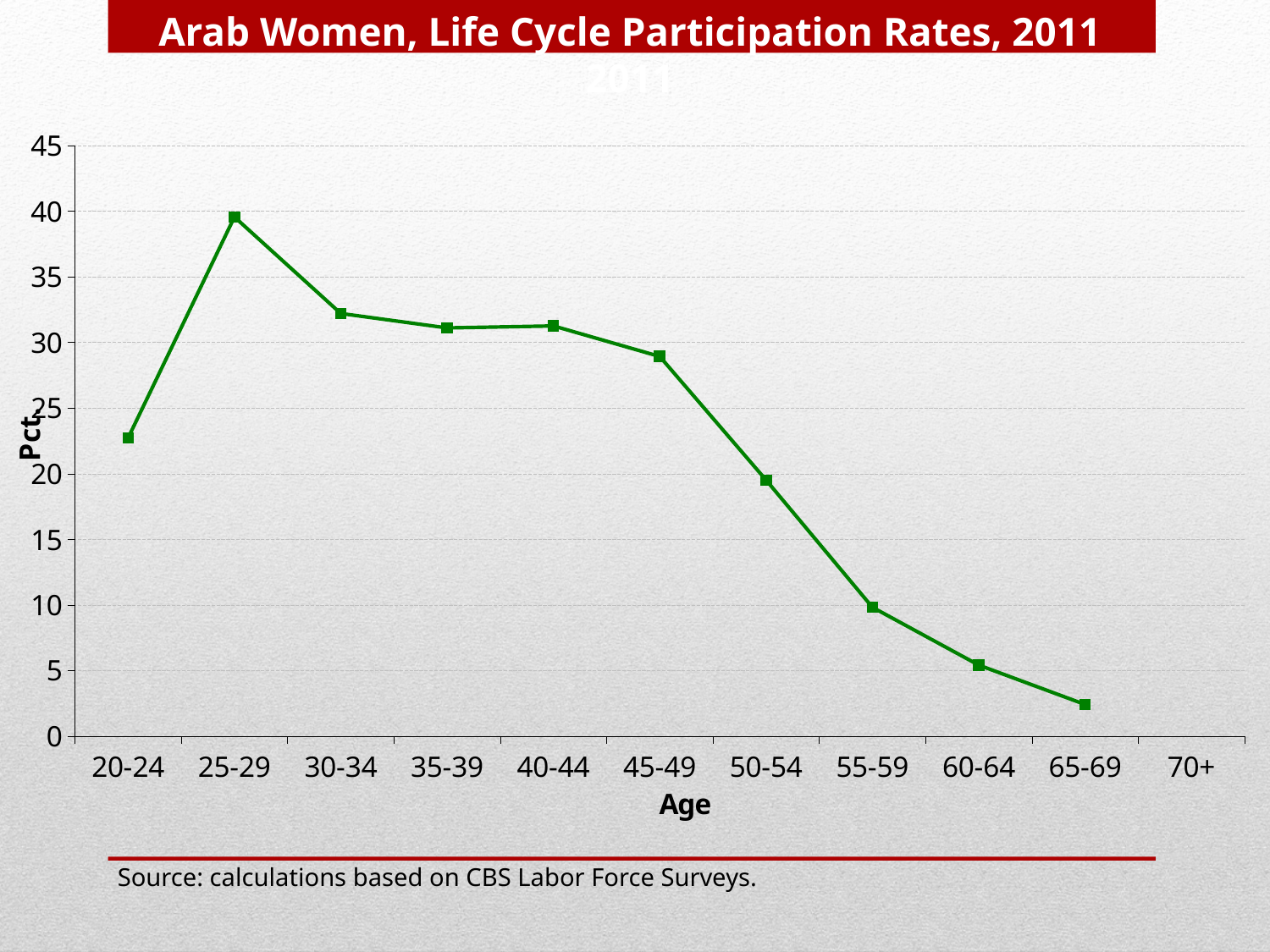
Which age group has the lowest plotted participation rate? 65-69 Is the value for 65-69 greater or less than 5? less What kind of chart is shown on the slide? line chart What is the title of the chart? Arab Women, Life Cycle Participation Rates, 2011 Do the values rise or fall from 45-49 to 65-69? fall Is the value for 55-59 greater or less than 15? less Which has a higher participation rate, 20-24 or 45-49? 45-49 What is the label of the x axis? Age Which age group has the highest participation rate? 25-29 Is the value for 25-29 greater or less than 35? greater How many age groups are labeled on the x axis? 11